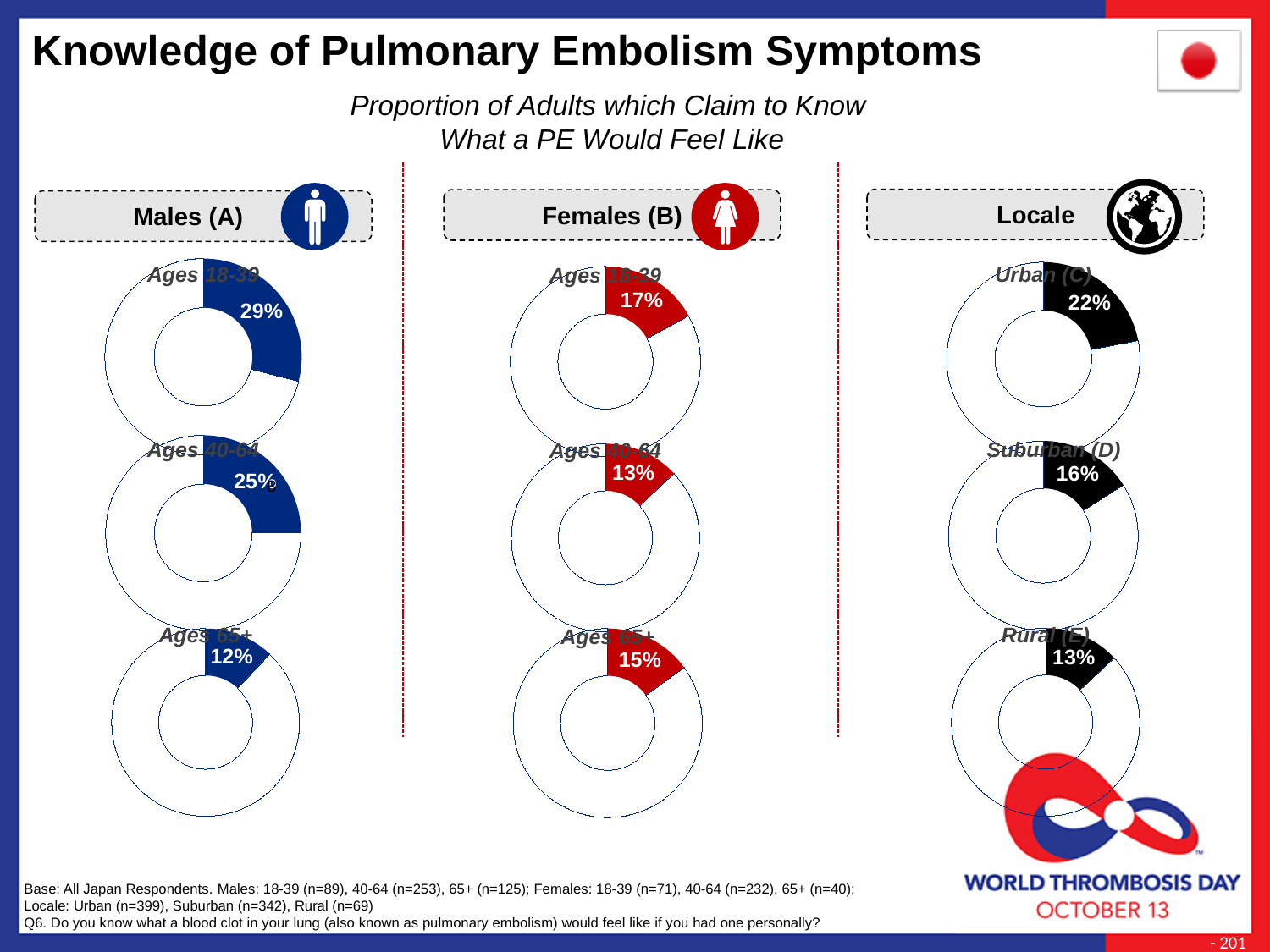
In the Males (A) column, what percentage of males aged 18-39 claim to know what a PE would feel like? 29% Which is larger: the Males (A) Ages 40-64 value or the Locale Suburban (D) value? Males (A) Ages 40-64 In the Locale column, what is the value shown for Rural (E)? 13% How many donut charts are shown in the Locale column? 3 Across the three Males (A) donut charts, which age group has the highest percentage? Ages 18-39 In the Females (B) column, what percentage of females aged 40-64 claim to know what a PE would feel like? 13% Across the three Locale donut charts, which locale has the highest percentage? Urban (C) What type of chart is used to show each percentage on this slide? Donut chart In the Locale column, what percentage of Urban (C) respondents claim to know what a PE would feel like? 22% In the Males (A) column, what is the value shown for males aged 65+? 12% Across the three Females (B) donut charts, which age group has the lowest percentage? Ages 40-64 What is the difference between the Males (A) Ages 18-39 value and the Females (B) Ages 18-39 value? 12%